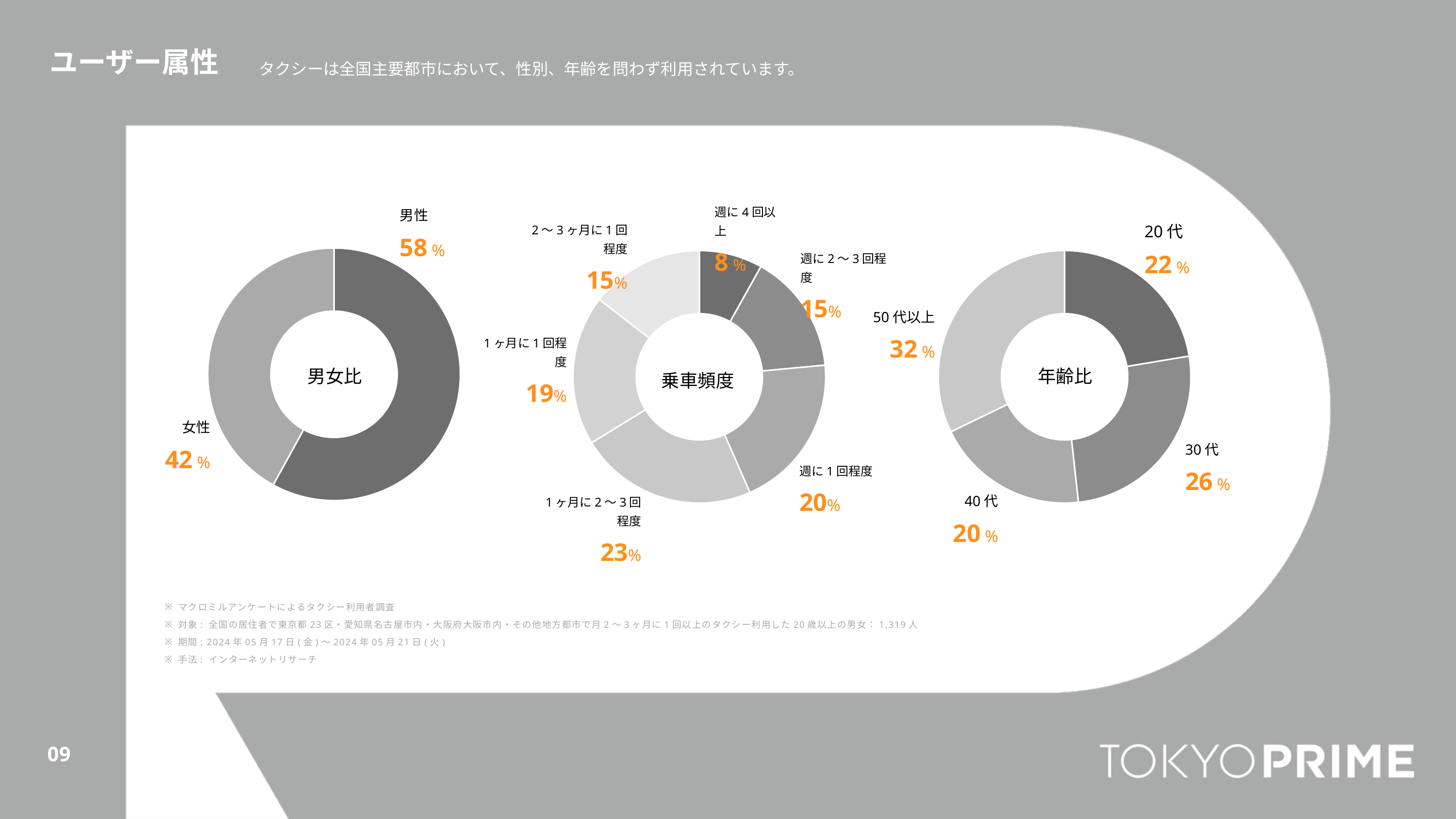
In the 男女比 chart, what is the difference between 男性 and 女性? 16% In the 乗車頻度 chart, which category has the smallest share? 週に 4 回以上 What kind of chart is the 年齢比 chart? Donut chart In the 乗車頻度 chart, which is larger, 週に 1 回程度 or 1 ヶ月に 1 回程度? 週に 1 回程度 In the 年齢比 chart, what is the difference between 30 代 and 20 代? 4% In the 男女比 chart, what percentage is 女性? 42% In the 年齢比 chart, which age group has the smallest share? 40 代 In the 男女比 chart, what percentage is 男性? 58% How many categories does the 乗車頻度 chart show? 6 In the 乗車頻度 chart, which category has the largest share? 1 ヶ月に 2 〜 3 回程度 In the 乗車頻度 chart, what percentage is 週に 4 回以上? 8% In the 年齢比 chart, what percentage is 50 代以上? 32%